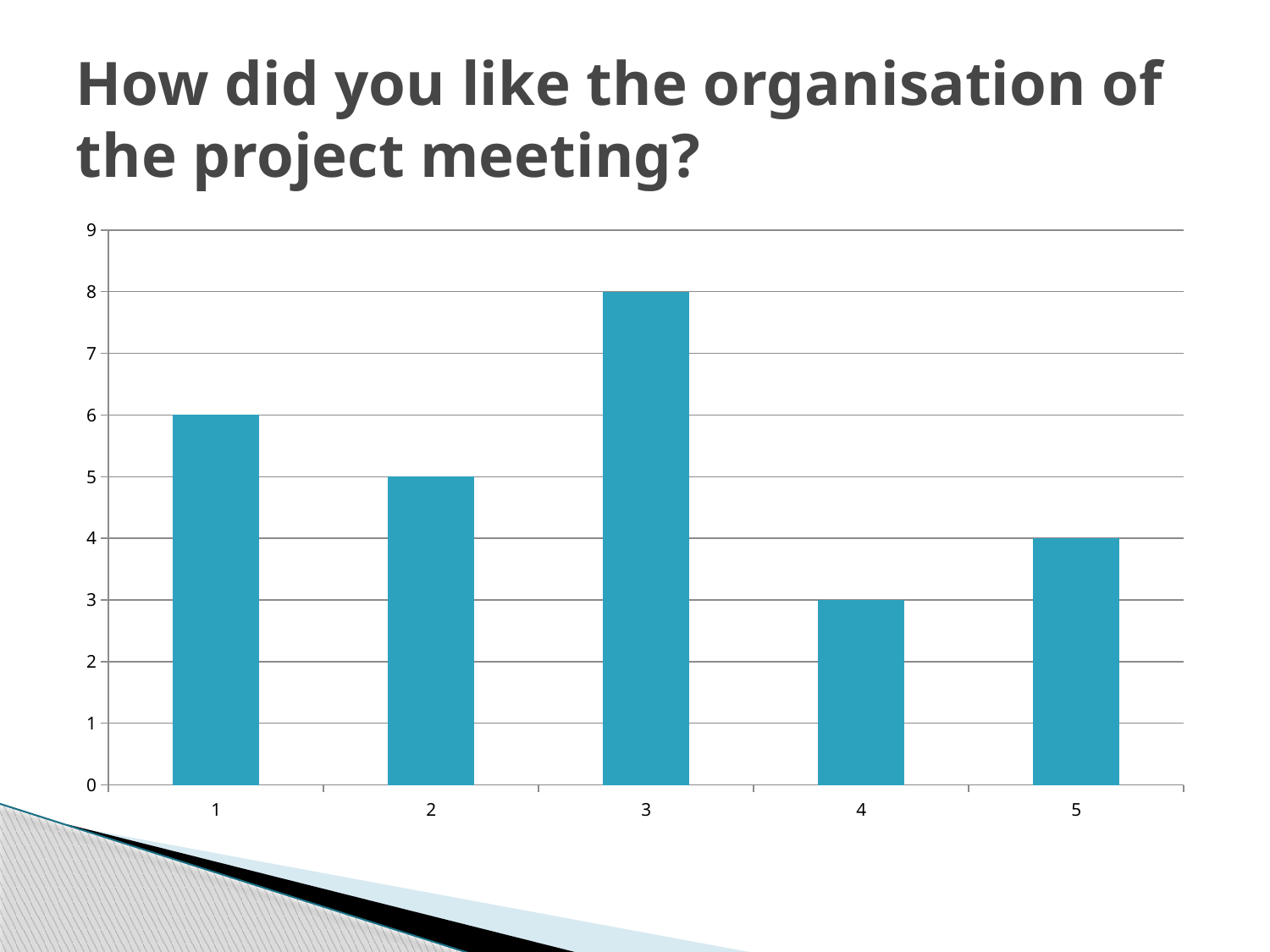
How many categories are shown on the x axis? 5 What is the value for category 1? 6 Which category has the highest value? 3 Is the value for category 1 greater or less than 5? greater Which is larger, the value for category 2 or the value for category 5? category 2 What kind of chart is shown on the slide? bar chart What is the highest value shown on the y axis? 9 Which category has the lowest value? 4 What is the value for category 3? 8 What is the value for category 4? 3 What is the title of the slide above the chart? How did you like the organisation of the project meeting? What is the difference between the values for category 3 and category 4? 5